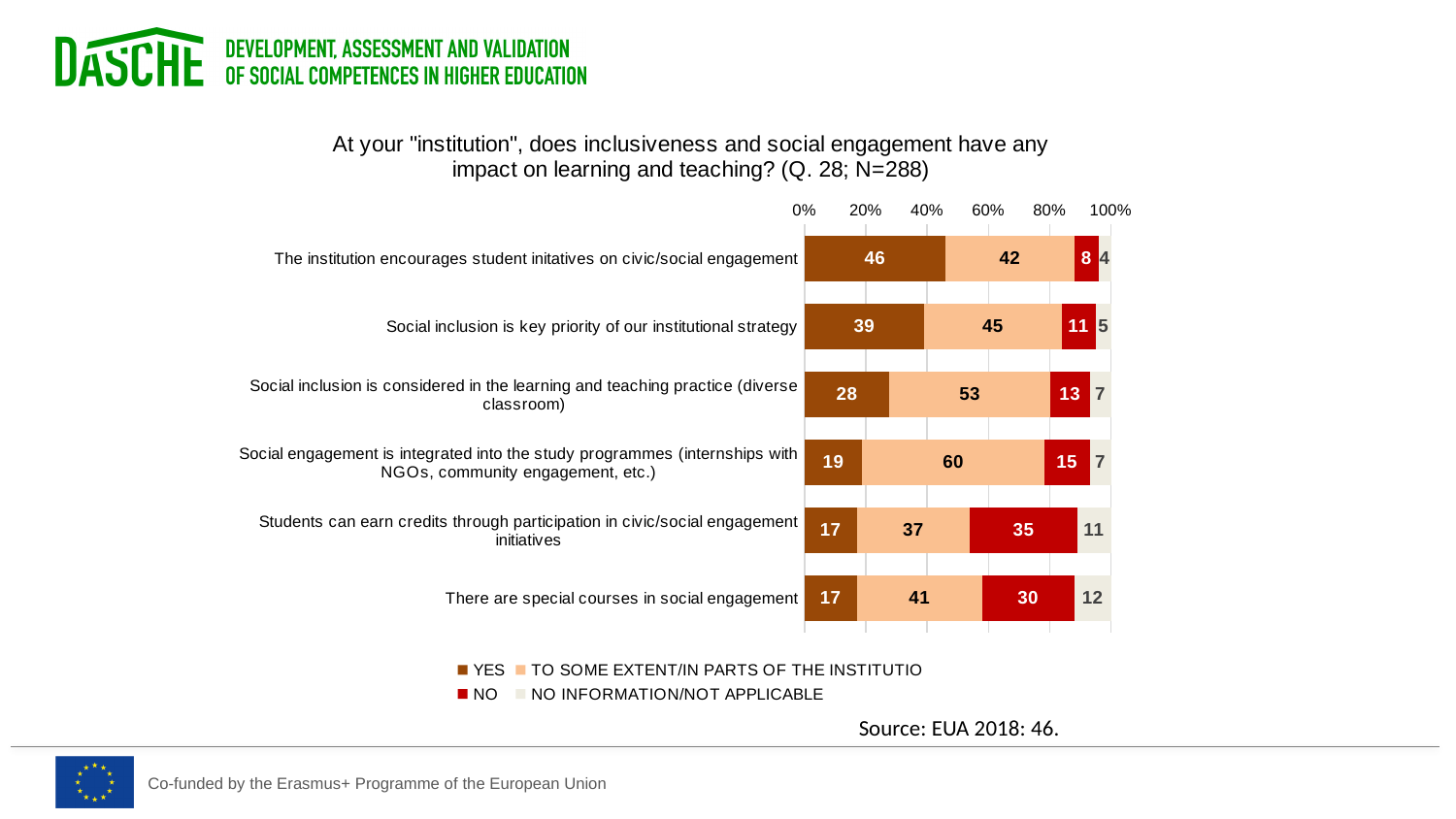
What is the TO SOME EXTENT/IN PARTS OF THE INSTITUTION value for "Social engagement is integrated into the study programmes"? 60 Which is larger: the NO value for "Students can earn credits through participation in civic/social engagement initiatives" or the NO value for "There are special courses in social engagement"? Students can earn credits through participation in civic/social engagement initiatives Which statement has the highest YES value? The institution encourages student initiatives on civic/social engagement Which statement has the lowest NO value? The institution encourages student initiatives on civic/social engagement What is the total of the stacked bar for "Social inclusion is considered in the learning and teaching practice (diverse classroom)"? 101 What is the YES value for "The institution encourages student initiatives on civic/social engagement"? 46 What kind of chart is shown on the slide? Stacked bar chart What is the difference between the YES values for "Social inclusion is key priority of our institutional strategy" and "Social inclusion is considered in the learning and teaching practice (diverse classroom)"? 11 How many categories (statements) are plotted in the chart? 6 How many series does the legend list? 4 What is the NO value for "Students can earn credits through participation in civic/social engagement initiatives"? 35 What is the NO INFORMATION/NOT APPLICABLE value for "There are special courses in social engagement"? 12